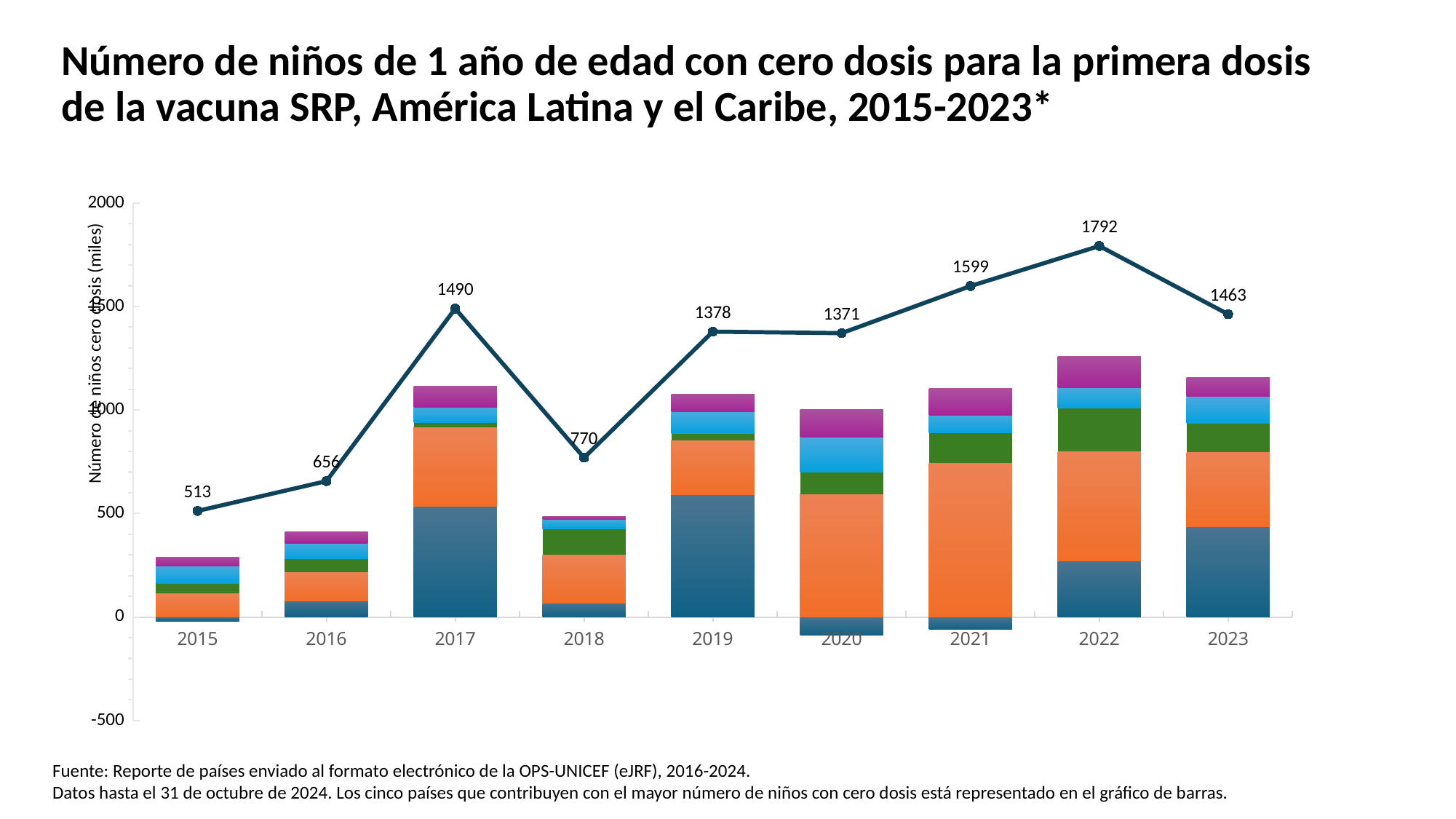
What is the value of the line for 2018? 770 In which year does the line have its lowest value? 2015 In which year does the line reach its highest value? 2022 What is the difference between the line values for 2022 and 2023? 329 Does the line rise or fall from 2022 to 2023? fall What is the value of the line for 2015? 513 What is the difference between the line values for 2017 and 2018? 720 What kinds of chart are combined on this slide? Stacked bar chart and line chart How many years are shown on the x axis? 9 Which year has a larger line value, 2019 or 2021? 2021 What is the value of the line for 2022? 1792 Is the line value for 2016 greater or less than 1000? less